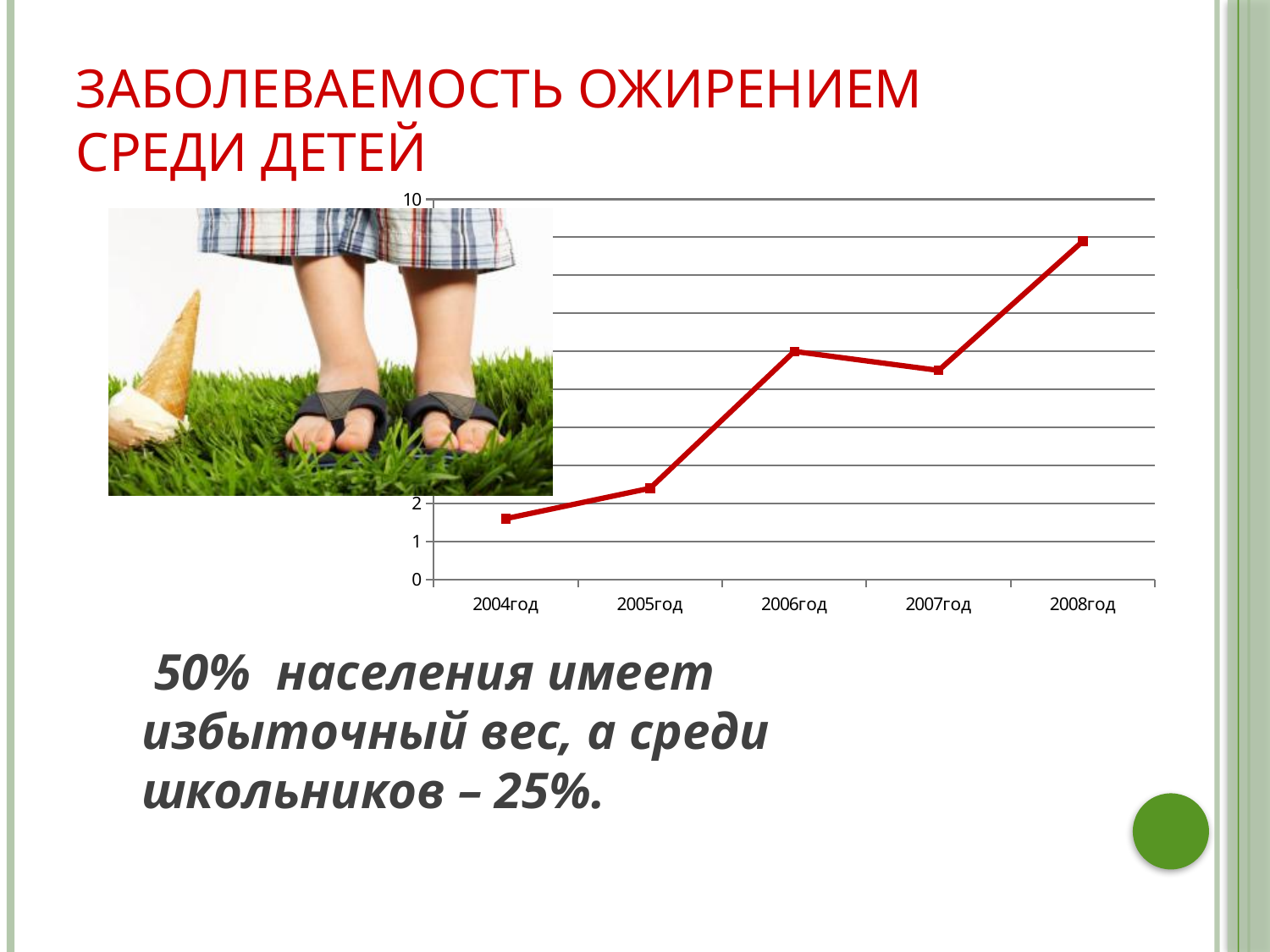
What colour is the line on the chart? red Is the value for 2008год greater or less than 10? less Is the value for 2006год greater or less than 2? greater Is the value for 2004год greater or less than 2? less Which is larger, the value for 2006год or the value for 2007год? 2006год Which year has the highest value on the chart? 2008год What kind of chart is shown on the slide? line chart Do the values generally rise or fall from 2004год to 2008год? rise Which year has the lowest value on the chart? 2004год Which is larger, the value for 2008год or the value for 2004год? 2008год How many years are plotted on the x axis of the chart? 5